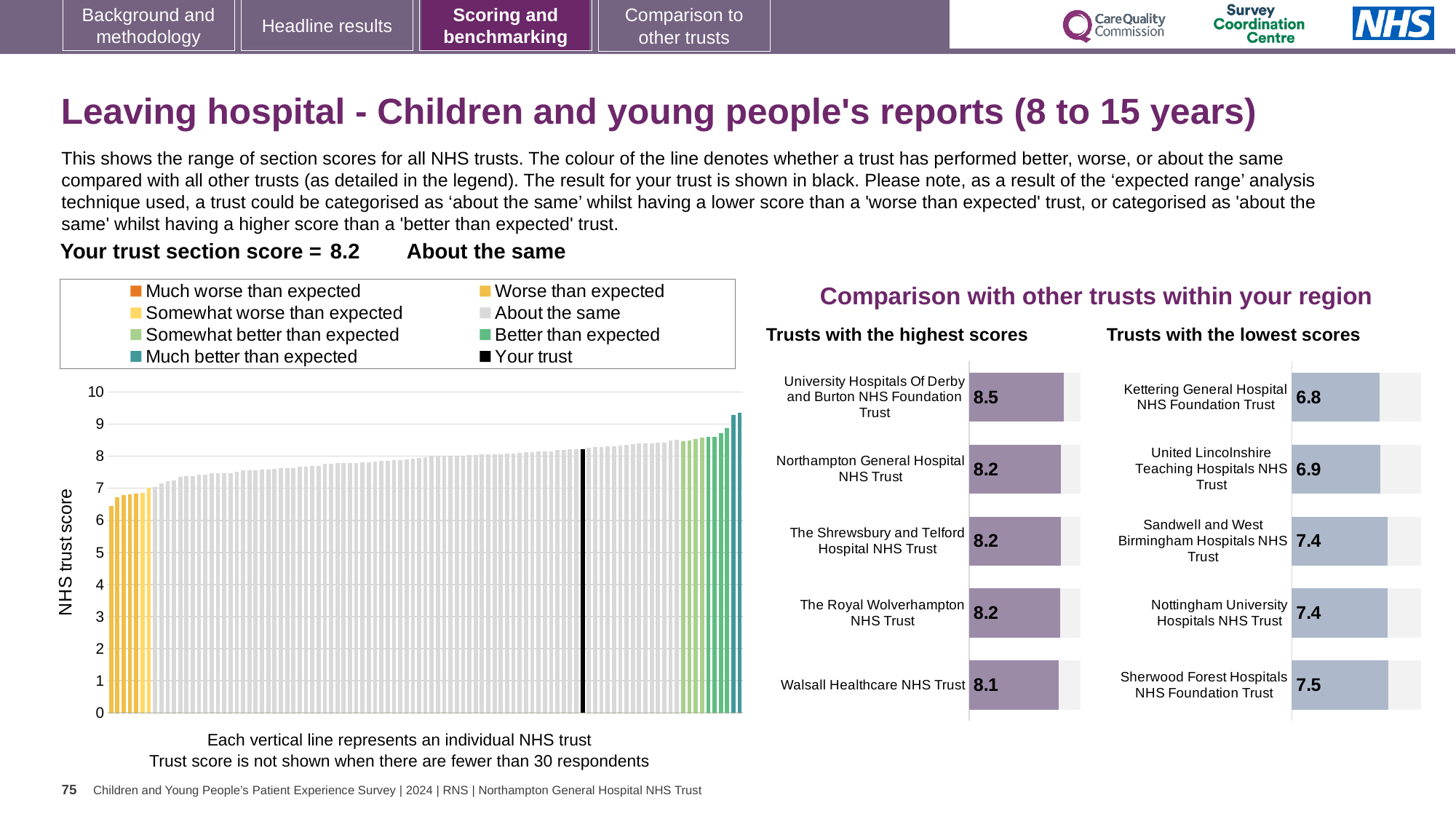
In the 'Trusts with the lowest scores' chart, which has the higher score: United Lincolnshire Teaching Hospitals NHS Trust or Kettering General Hospital NHS Foundation Trust? United Lincolnshire Teaching Hospitals NHS Trust How many entries does the legend of the large chart on the left list? 8 In the 'Trusts with the highest scores' chart, which trust has the highest score? University Hospitals Of Derby and Burton NHS Foundation Trust In the 'Trusts with the lowest scores' chart, what is the score for Kettering General Hospital NHS Foundation Trust? 6.8 In the large chart on the left, do the trust scores rise or fall from left to right? Rise In the 'Trusts with the highest scores' chart, what is the score for Walsall Healthcare NHS Trust? 8.1 In the 'Trusts with the highest scores' chart, what is the difference between the scores of University Hospitals Of Derby and Burton NHS Foundation Trust and Walsall Healthcare NHS Trust? 0.4 In the 'Trusts with the lowest scores' chart, which trust has the lowest score? Kettering General Hospital NHS Foundation Trust What kind of chart is the large chart on the left showing NHS trust scores? Bar chart In the 'Trusts with the lowest scores' chart, what is the score for Sherwood Forest Hospitals NHS Foundation Trust? 7.5 How many trusts are shown in the 'Trusts with the lowest scores' chart? 5 In the 'Trusts with the highest scores' chart, what is the score for University Hospitals Of Derby and Burton NHS Foundation Trust? 8.5